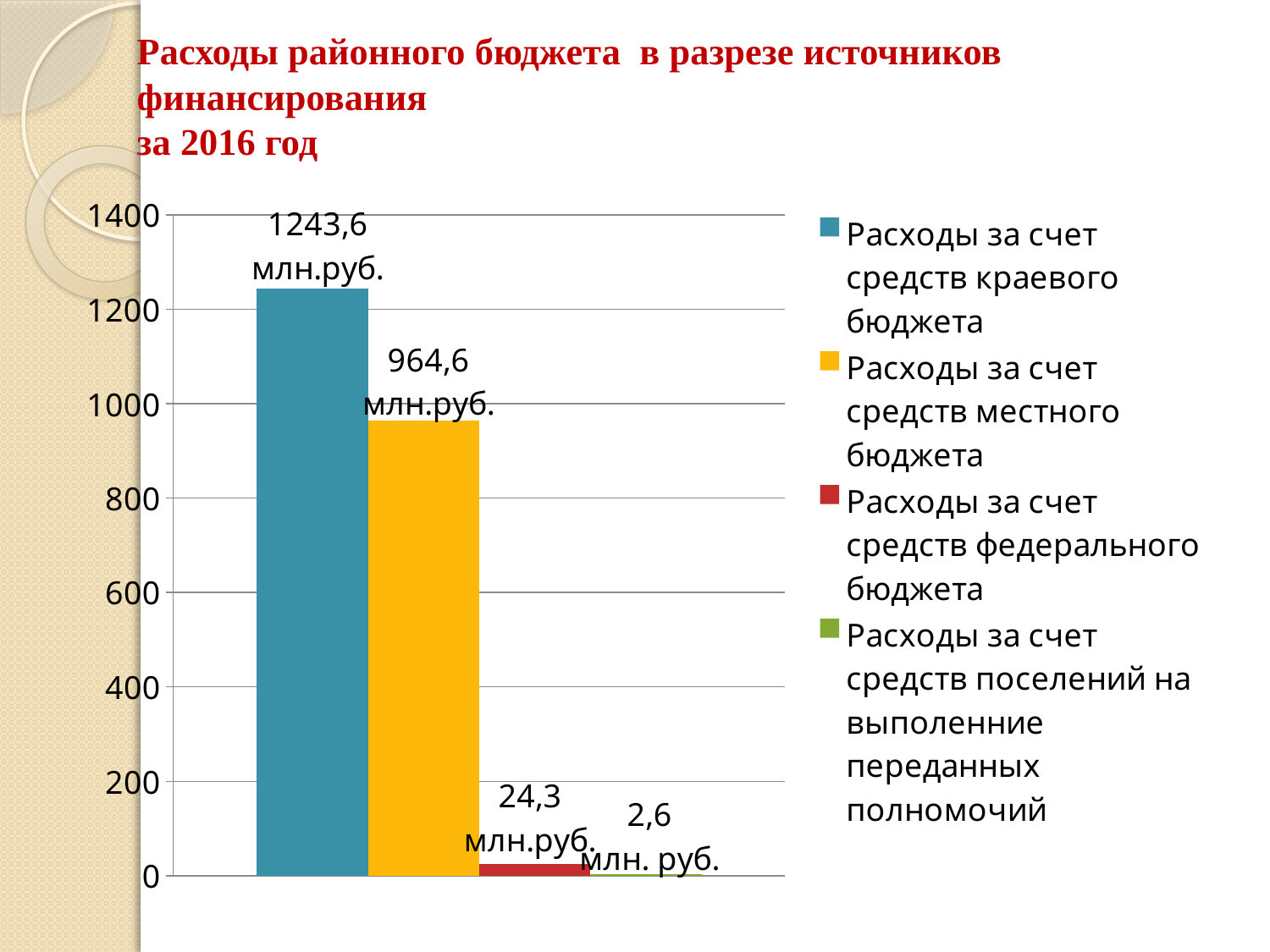
How many series does the legend list? 4 Which is larger: expenditure from the местный бюджет or from the федеральный бюджет? Расходы за счет средств местного бюджета Which funding source has the highest expenditure? Расходы за счет средств краевого бюджета What is the value of the bar for 'Расходы за счет средств поселений на выполенние переданных полномочий'? 2,6 млн. руб. Which funding source has the lowest expenditure? Расходы за счет средств поселений на выполенние переданных полномочий What is the value of the bar for 'Расходы за счет средств местного бюджета'? 964,6 млн.руб. What is the difference between the expenditure from the краевой бюджет and the местный бюджет? 279 млн.руб. What is the difference between the expenditure from the федеральный бюджет and from средств поселений? 21,7 млн.руб. What kind of chart is shown on the slide? Bar chart What is the value of the bar for 'Расходы за счет средств краевого бюджета'? 1243,6 млн.руб. Is the value for 'Расходы за счет средств местного бюджета' greater or less than 1000? less What is the value of the bar for 'Расходы за счет средств федерального бюджета'? 24,3 млн.руб.